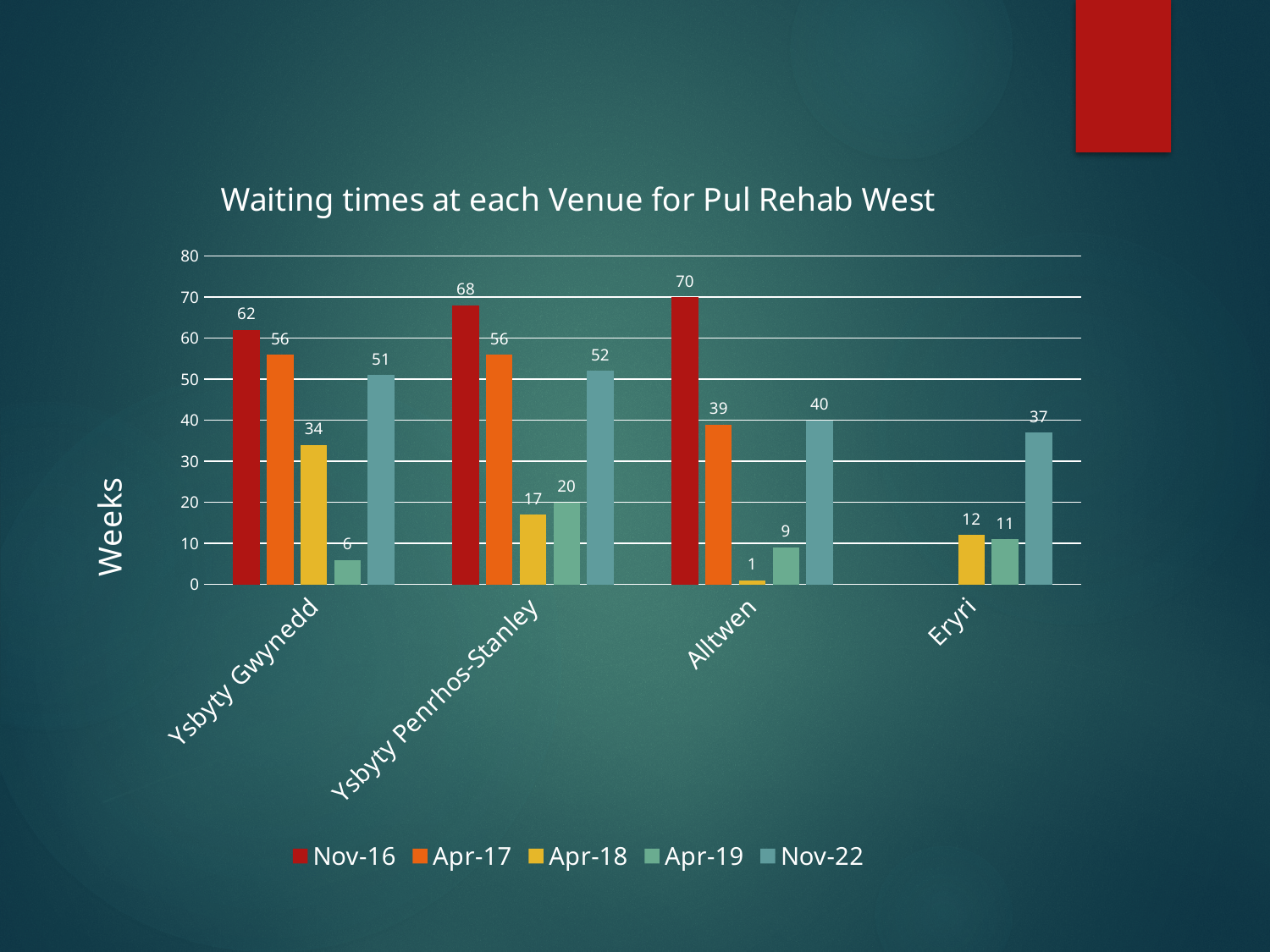
What is the difference between the Nov-16 and Nov-22 waiting times for Ysbyty Penrhos-Stanley? 16 Which venue has the lowest Apr-18 waiting time? Alltwen What is the label on the vertical axis? Weeks What is the Nov-16 waiting time for Alltwen? 70 What is the title of the chart? Waiting times at each Venue for Pul Rehab West What is the Nov-22 waiting time for Eryri? 37 Which venue has the highest Nov-16 waiting time? Alltwen Which is larger for Ysbyty Gwynedd: the Apr-17 value or the Nov-22 value? Apr-17 How many series does the legend list? 5 What kind of chart is shown on the slide? Bar chart How many venues are shown on the x axis? 4 What is the Apr-18 waiting time for Ysbyty Gwynedd? 34